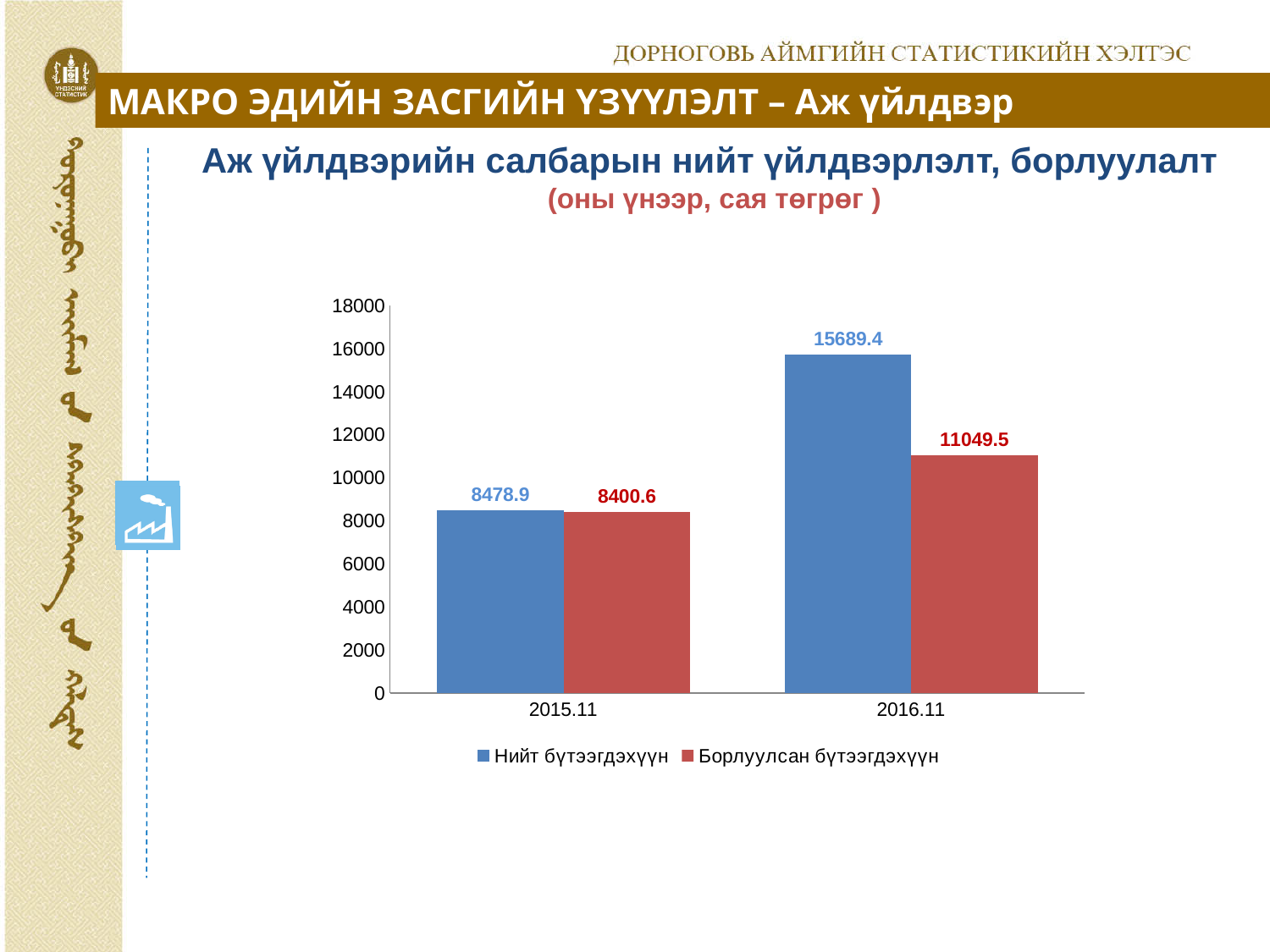
What is the difference between Нийт бүтээгдэхүүн and Борлуулсан бүтээгдэхүүн in 2016.11? 4639.9 By how much did Нийт бүтээгдэхүүн increase from 2015.11 to 2016.11? 7210.5 How many series does the legend list? 2 Is the value of Борлуулсан бүтээгдэхүүн for 2016.11 greater or less than 10000? greater What is the value of Борлуулсан бүтээгдэхүүн for 2015.11? 8400.6 Which bar has the highest value on the chart? Нийт бүтээгдэхүүн, 2016.11 What type of chart is shown on the slide? Bar chart How many time periods are shown on the x axis? 2 What is the value of Нийт бүтээгдэхүүн for 2015.11? 8478.9 Which is larger in 2015.11: Нийт бүтээгдэхүүн or Борлуулсан бүтээгдэхүүн? Нийт бүтээгдэхүүн What is the value of Борлуулсан бүтээгдэхүүн for 2016.11? 11049.5 What is the value of Нийт бүтээгдэхүүн for 2016.11? 15689.4